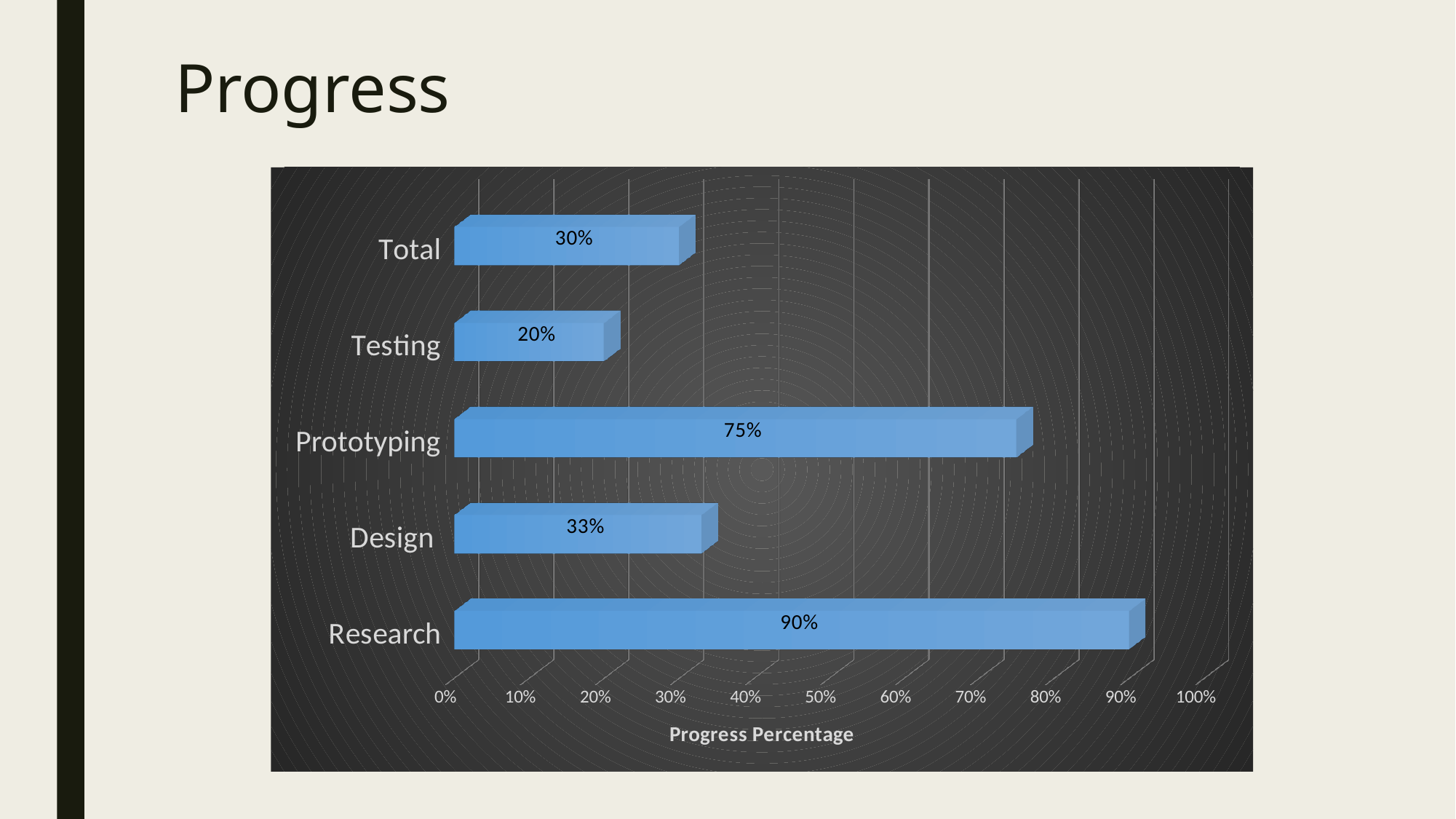
Which has a higher progress percentage, Design or Testing? Design Which category has the lowest progress percentage? Testing How many categories are shown on the chart? 5 What is the progress percentage for Prototyping? 75% What is the progress percentage for Research? 90% What is the difference between the progress percentages for Research and Prototyping? 15% What is the progress percentage shown for Total? 30% What kind of chart is shown on the slide? Bar chart What is the progress percentage for Design? 33% What is the progress percentage for Testing? 20% Which category has the highest progress percentage? Research What is the label of the horizontal axis? Progress Percentage